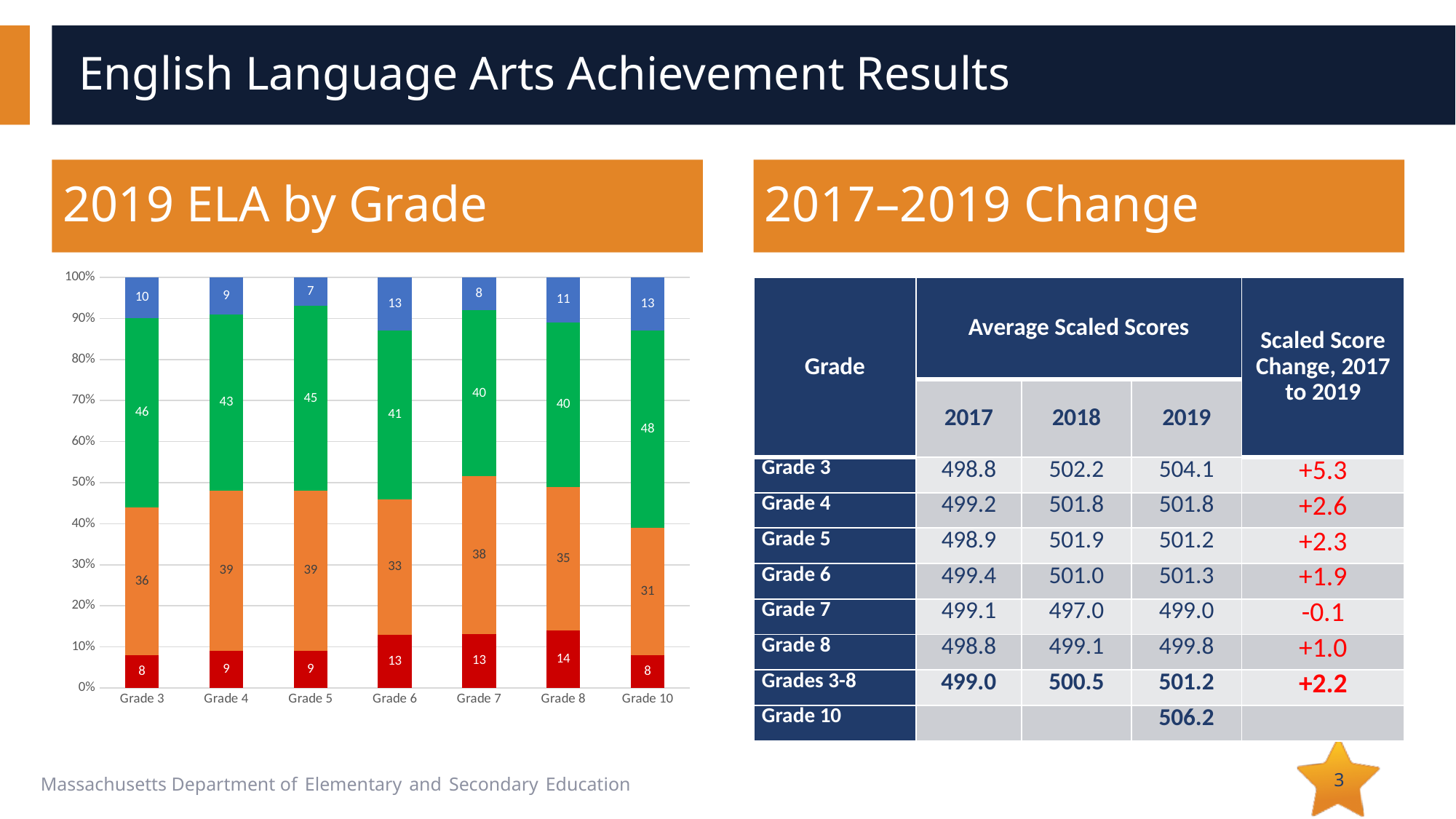
What is the difference between the orange segment values for Grade 4 and Grade 10? 8 How many grade categories are shown on the x axis of the chart? 7 What type of chart is shown under the heading '2019 ELA by Grade'? stacked bar chart What is the value of the blue (top) segment for Grade 6? 13 Which grade has the smallest blue (top) segment? Grade 5 Which grade has the largest green segment? Grade 10 What is the value of the green segment for Grade 10? 48 What is the value of the red (bottom) segment for Grade 8? 14 What is the title shown above the bar chart? 2019 ELA by Grade What is the value of the orange segment for Grade 3? 36 What is the total of the four segments in the Grade 5 bar? 100 Which is larger, the red segment for Grade 7 or the red segment for Grade 3? Grade 7